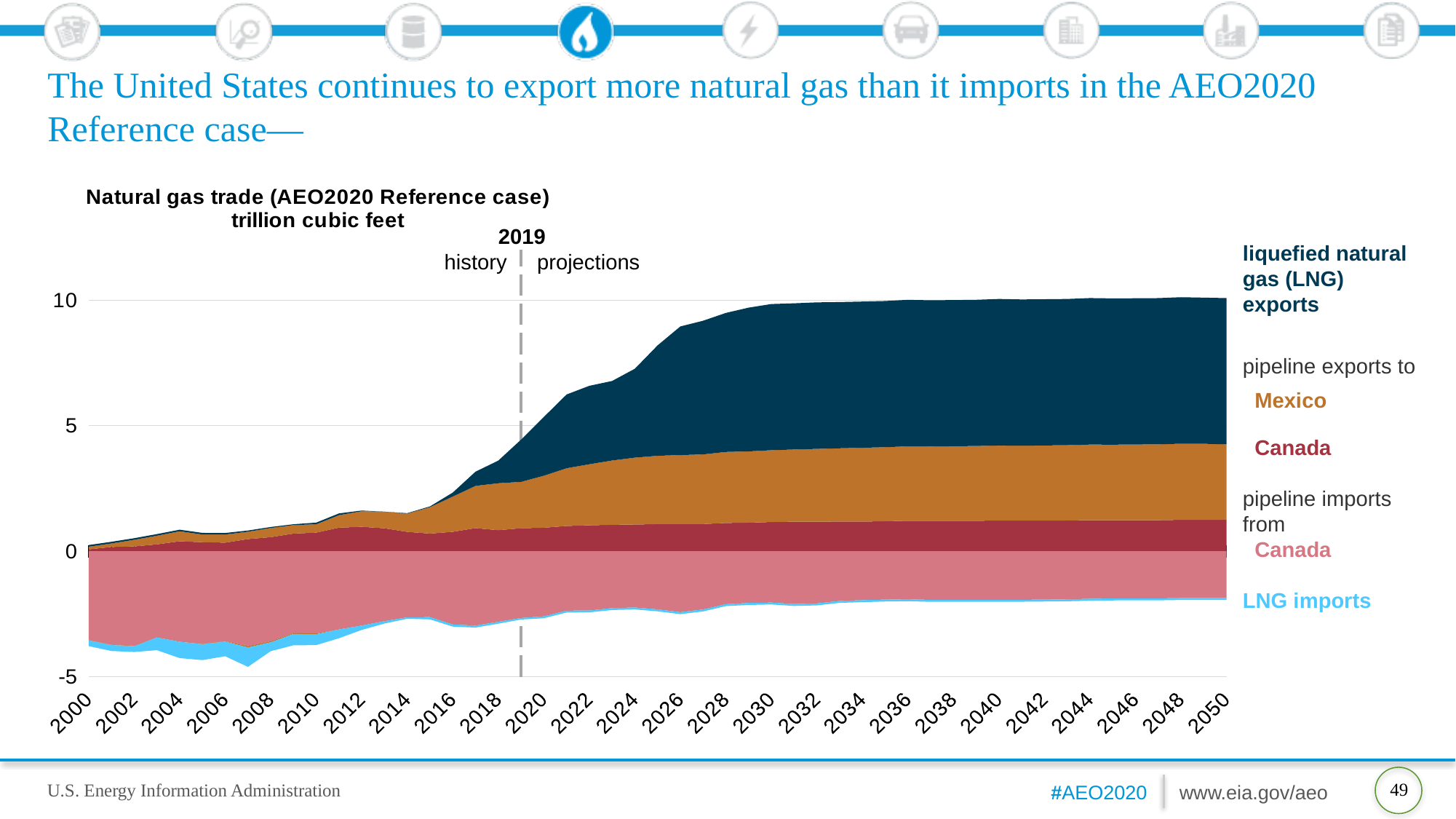
Which year marks the boundary between history and projections on the chart? 2019 Is the total of natural gas exports (the stacked area above zero) in 2010 greater or less than 5 trillion cubic feet? less Is the total of natural gas exports (the stacked area above zero) in 2050 greater or less than 5 trillion cubic feet? greater How many year labels are shown on the x axis? 26 In 2050, which is larger: pipeline exports to Mexico or pipeline exports to Canada? pipeline exports to Mexico Which export series is the largest in 2050? liquefied natural gas (LNG) exports What kind of chart is shown on the slide? Stacked area chart Do total natural gas exports rise or fall between 2019 and 2030? rise Does the magnitude of total natural gas imports (the area below zero) get larger or smaller from 2000 to 2050? smaller What unit is the chart's vertical axis measured in? trillion cubic feet How many series does the chart's legend list? 5 What is the title of the chart? Natural gas trade (AEO2020 Reference case)